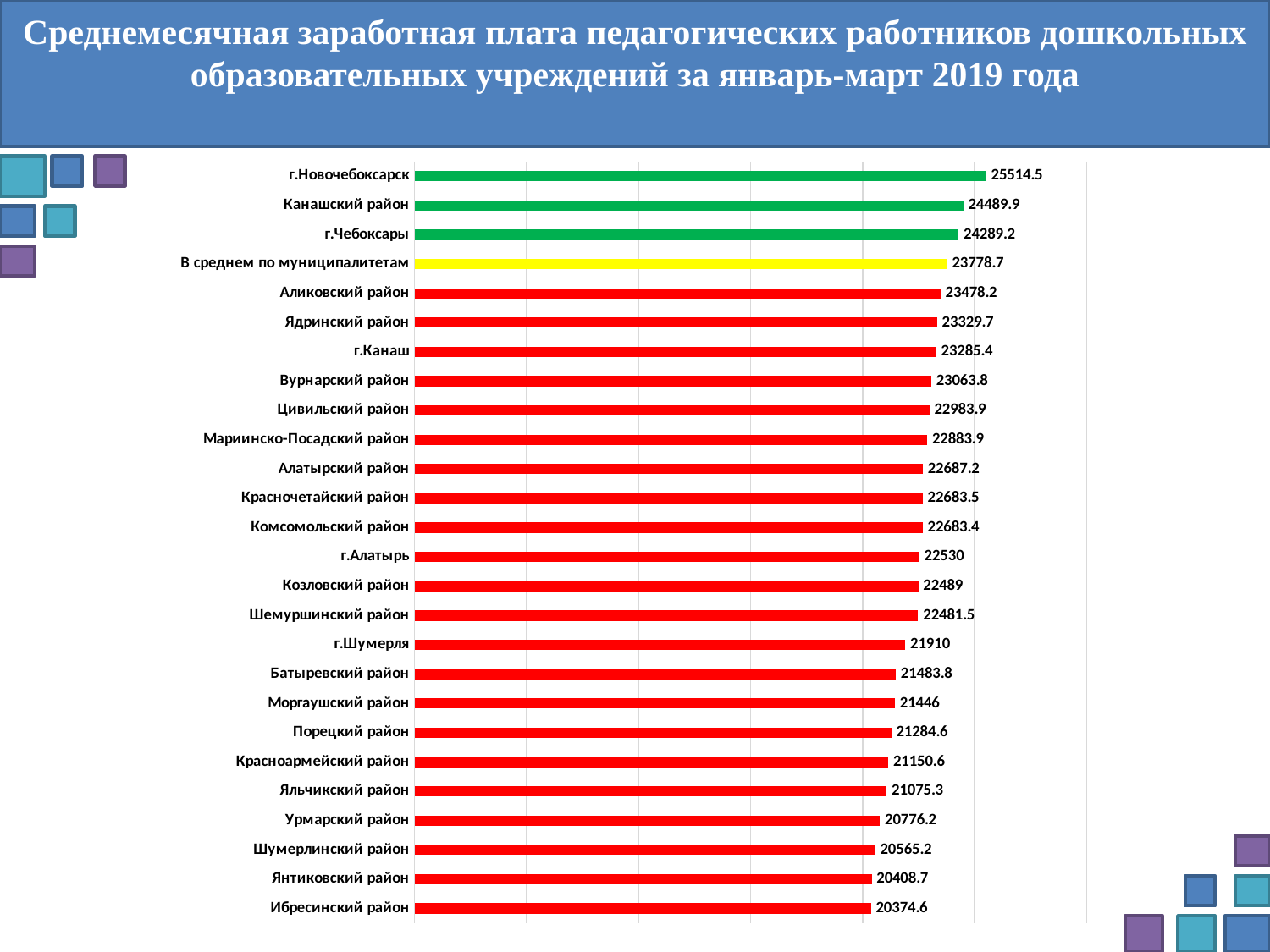
What is the difference between the values for Канашский район and г.Чебоксары? 200.7 How many categories are shown in the chart? 26 What is the value for Ибресинский район? 20374.6 What kind of chart is shown on the slide? Bar chart What is the value for Козловский район? 22489 Which category has the highest value? г.Новочебоксарск What is the value for г.Новочебоксарск? 25514.5 What is the value for В среднем по муниципалитетам? 23778.7 Which is larger, the value for г.Шумерля or the value for Батыревский район? г.Шумерля Which category has the lowest value? Ибресинский район What is the difference between the values for г.Новочебоксарск and Ибресинский район? 5139.9 What colour is the bar for В среднем по муниципалитетам? Yellow